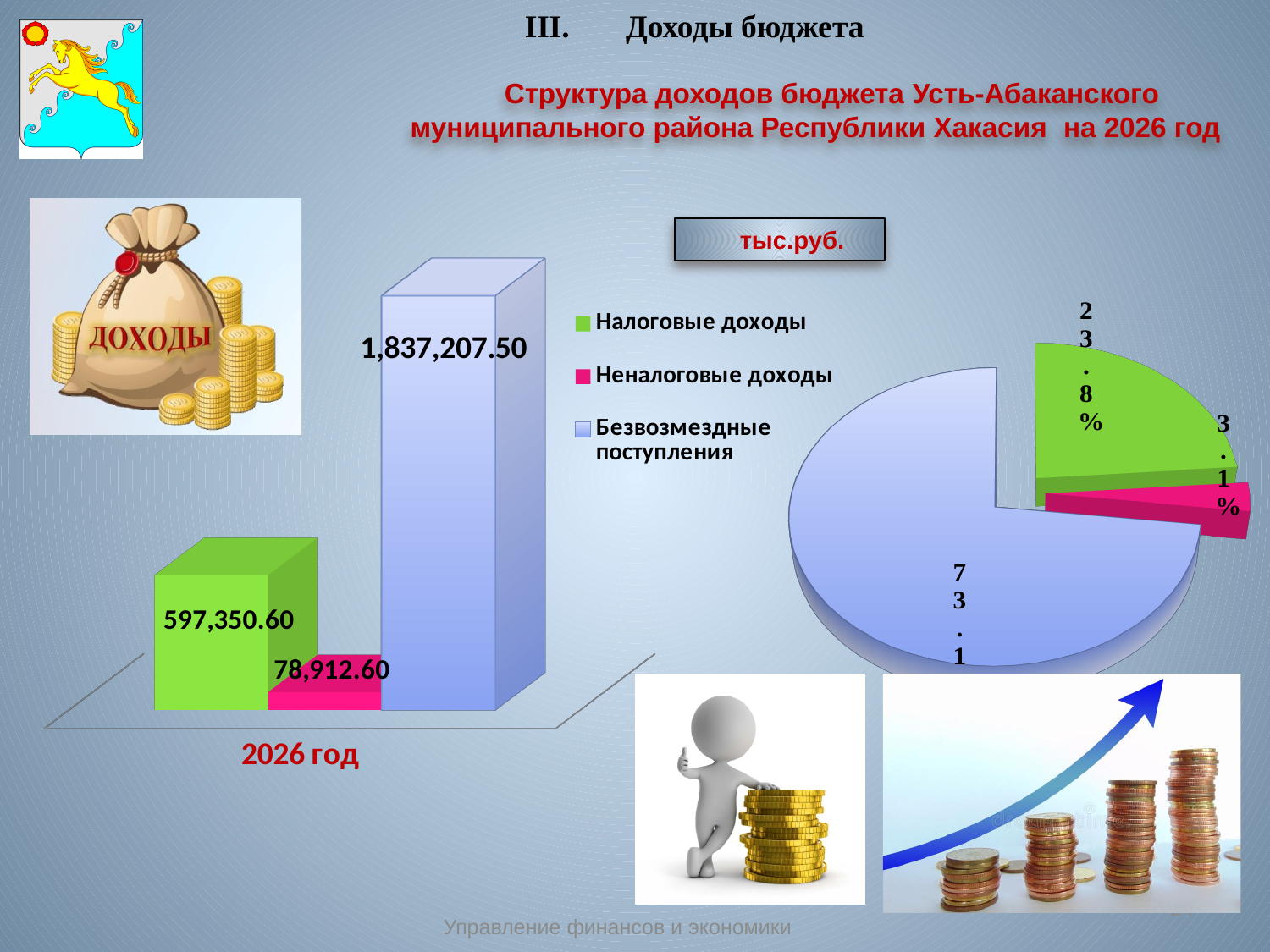
How many series does the legend list? 3 In the pie chart on the right, what share does Неналоговые доходы (pink slice) have? 3.1% In the bar chart on the left, which is larger: Налоговые доходы or Неналоговые доходы? Налоговые доходы In the bar chart on the left, what is the value for Безвозмездные поступления? 1,837,207.50 In the bar chart on the left, which series has the highest value? Безвозмездные поступления In the bar chart on the left, what is the difference between Налоговые доходы and Неналоговые доходы? 518,438.00 In the bar chart on the left, what is the value for Неналоговые доходы? 78,912.60 In the bar chart on the left, what is the value for Налоговые доходы? 597,350.60 In the bar chart on the left, which series has the lowest value? Неналоговые доходы In the pie chart on the right, what share does Налоговые доходы (green slice) have? 23.8% What kind of chart is shown on the left side of the slide? Bar chart In the bar chart on the left, what year label is shown under the bars? 2026 год